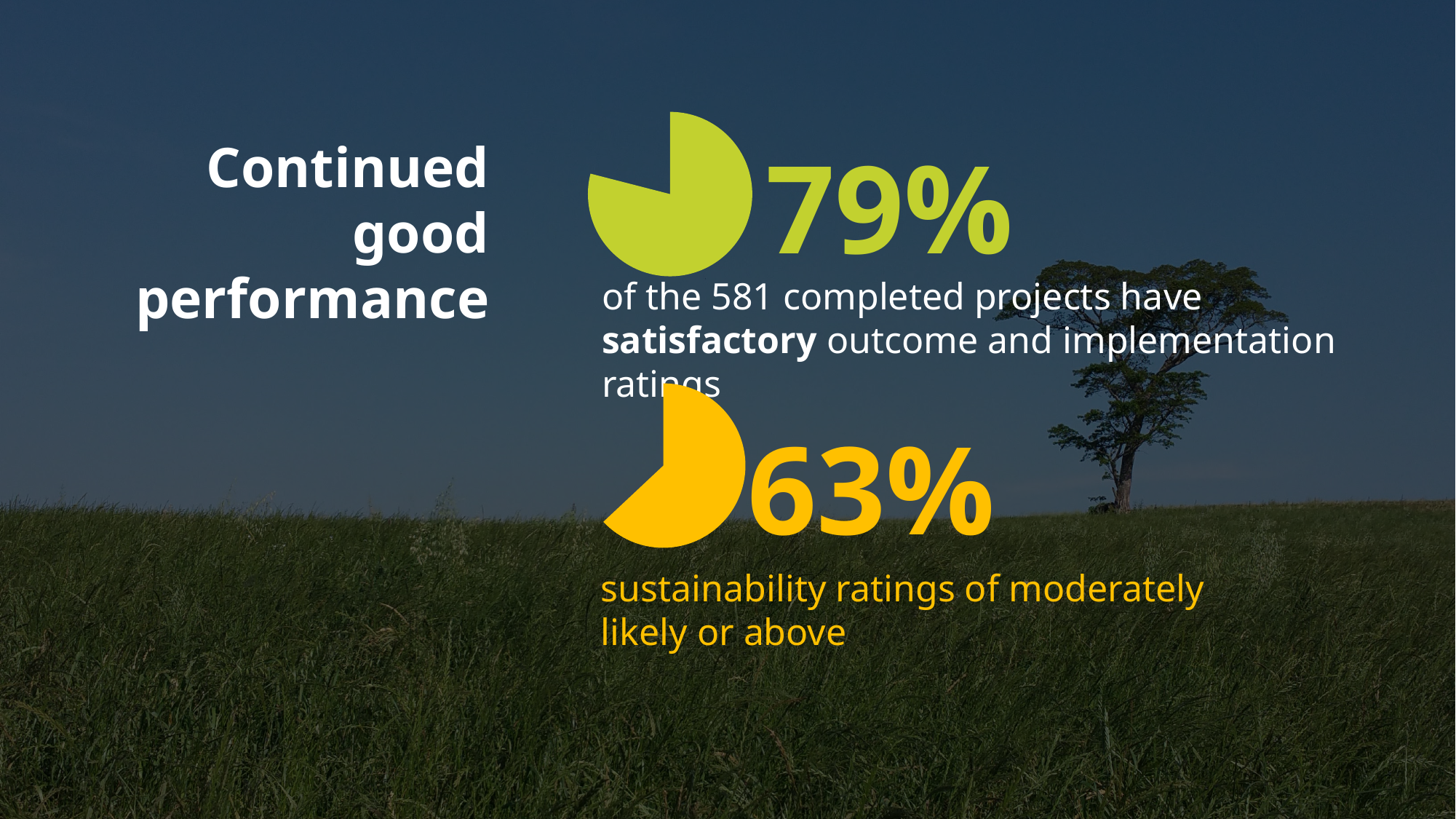
What kind of chart is used to show the 79% figure on the top of the slide? pie chart How many charts are shown on the slide? 2 Is the value shown on the top chart greater or less than 75%? greater Is the value shown on the bottom chart greater or less than 50%? greater Which is larger: the share with satisfactory outcome and implementation ratings (top chart) or the share with sustainability ratings of moderately likely or above (bottom chart)? satisfactory outcome and implementation ratings How many completed projects does the top chart's caption say were rated? 581 What colour is the pie chart showing the 63% sustainability figure? yellow What is the difference in percentage points between the value on the top chart (79%) and the value on the bottom chart (63%)? 16 On the bottom chart, what percentage of projects have sustainability ratings of moderately likely or above? 63% On the top chart, what percentage of the 581 completed projects have satisfactory outcome and implementation ratings? 79%